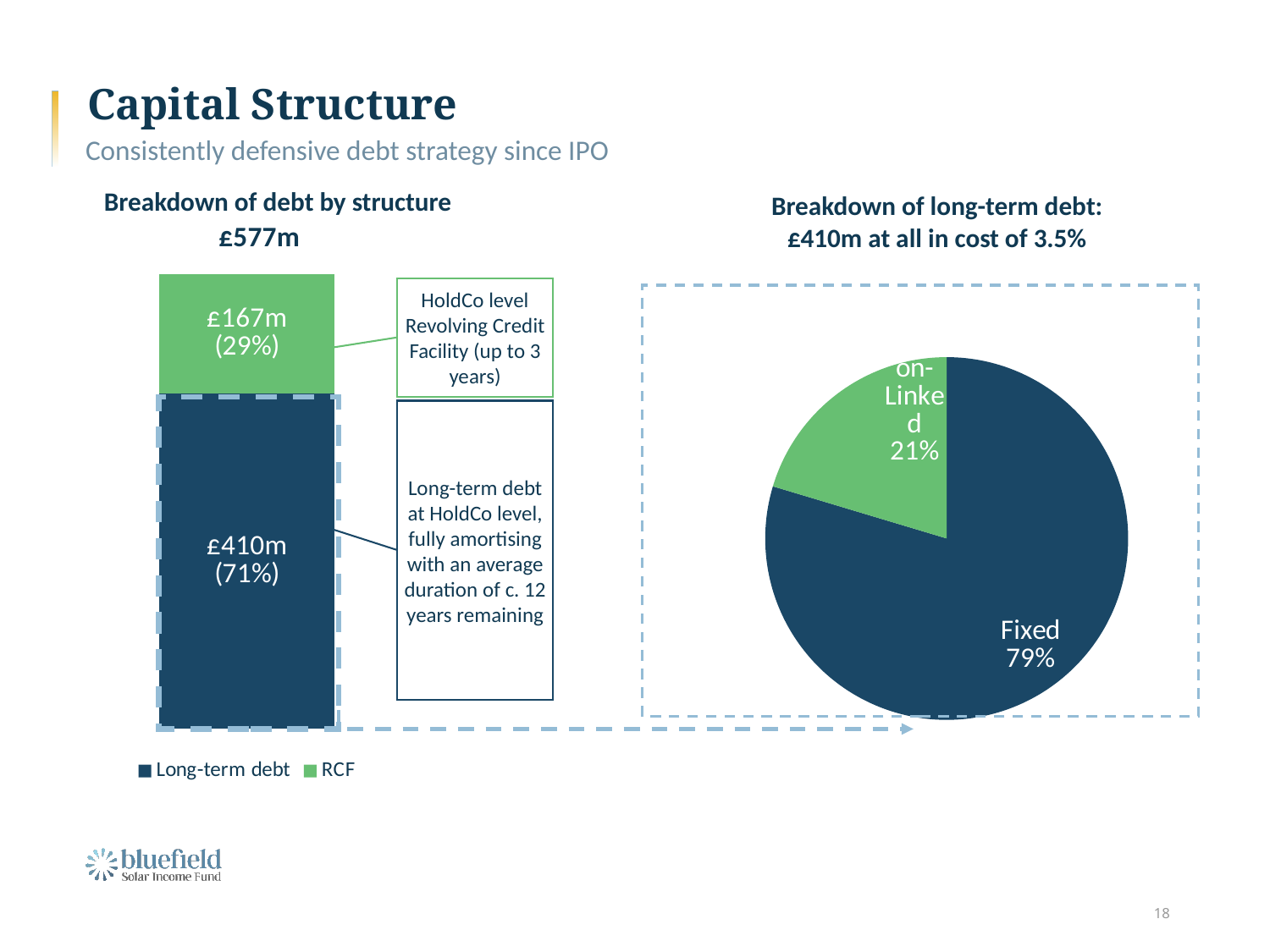
In the 'Breakdown of debt by structure' chart, what percentage of the total does RCF represent? 29% How many series does the legend of the 'Breakdown of debt by structure' chart list? 2 In the 'Breakdown of debt by structure' chart, what percentage of the total does Long-term debt represent? 71% In the 'Breakdown of debt by structure' chart, what is the total of the stacked bar? £577m In the 'Breakdown of debt by structure' chart, what is the value shown for Long-term debt? £410m In the 'Breakdown of debt by structure' chart, which is larger, Long-term debt or RCF? Long-term debt In the 'Breakdown of debt by structure' chart, what is the difference between the Long-term debt and RCF values? £243m In the 'Breakdown of long-term debt' pie chart, what share does the green slice (the slice other than Fixed) represent? 21% In the 'Breakdown of long-term debt' pie chart, which slice is the largest? Fixed In the 'Breakdown of debt by structure' chart, what is the value shown for RCF? £167m What kind of chart is the 'Breakdown of debt by structure' chart? Stacked bar chart